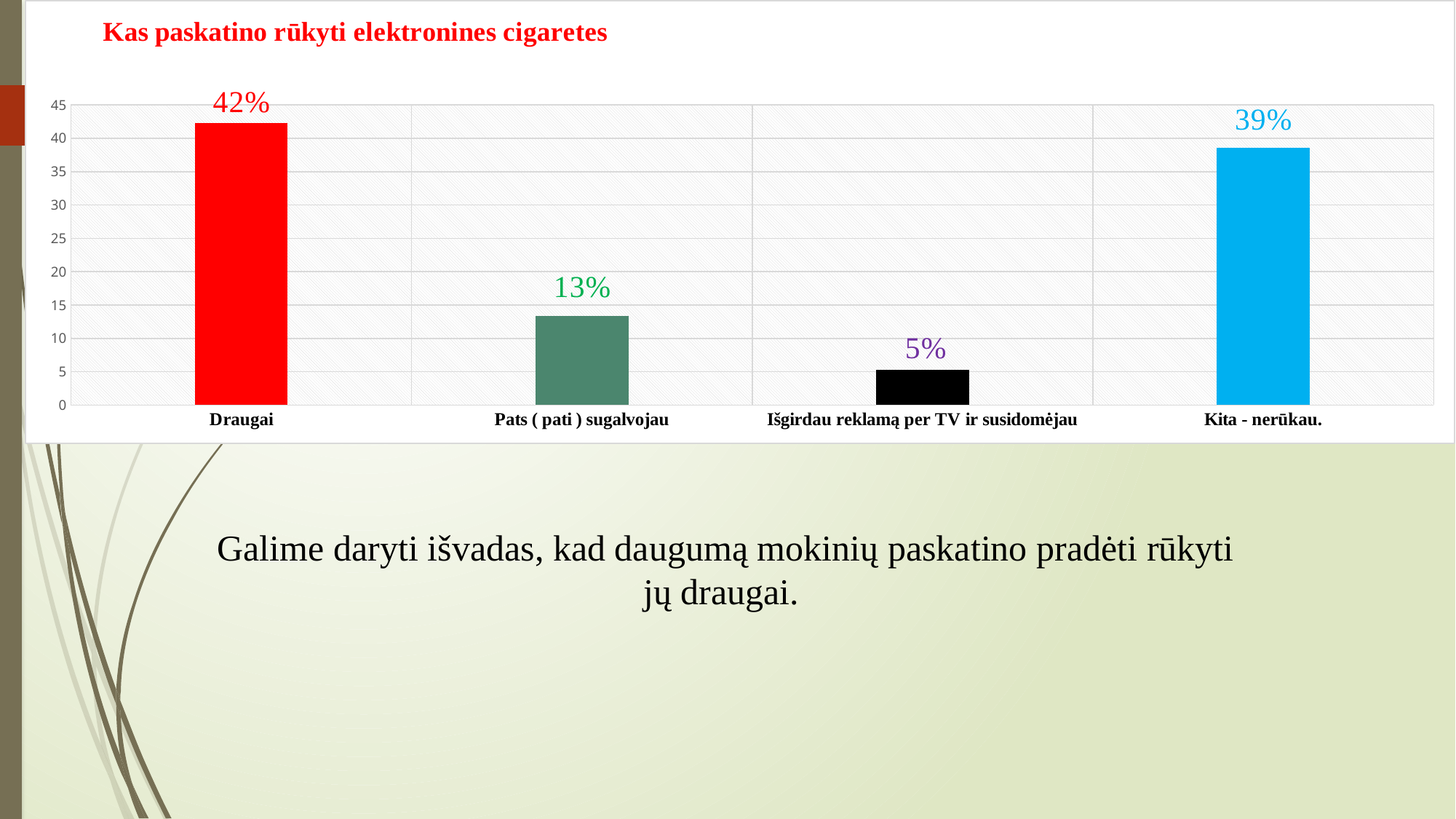
What is the value for Kita - nerūkau.? 39% Which category has the highest value? Draugai What is the title of the chart? Kas paskatino rūkyti elektronines cigaretes What kind of chart is shown on the slide? bar chart What is the difference between the values for Draugai and Kita - nerūkau.? 3% How many categories are shown in the chart? 4 What is the value for Draugai? 42% Which category has the lowest value? Išgirdau reklamą per TV ir susidomėjau What is the value for Pats ( pati ) sugalvojau? 13% What is the value for Išgirdau reklamą per TV ir susidomėjau? 5% Which is larger, the value for Pats ( pati ) sugalvojau or the value for Išgirdau reklamą per TV ir susidomėjau? Pats ( pati ) sugalvojau Is the value for Kita - nerūkau. greater or less than 35? greater